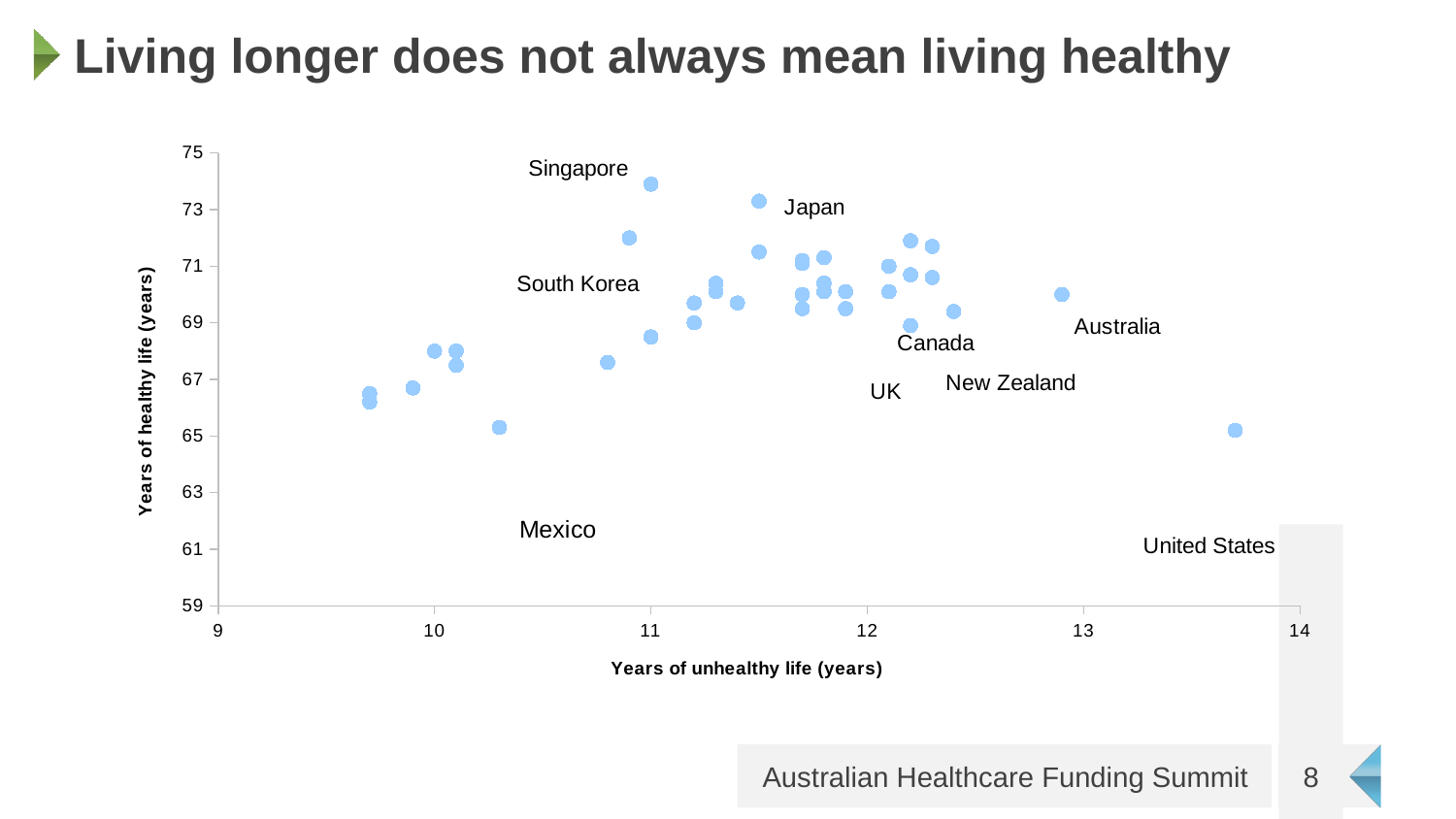
Which has more years of healthy life, Singapore or the United States? Singapore Which has more years of healthy life, Australia or the United States? Australia Is the years of healthy life value for Singapore greater or less than 73? greater What kind of chart is shown on the slide? scatter chart Which has more years of unhealthy life, Australia or Japan? Australia Which labelled country has the highest years of healthy life? Singapore Is the years of unhealthy life value for the United States greater or less than 13? greater What is the title of the horizontal axis of the chart? Years of unhealthy life (years) What is the title of the vertical axis of the chart? Years of healthy life (years) Is the years of healthy life value for Japan greater or less than 72? greater